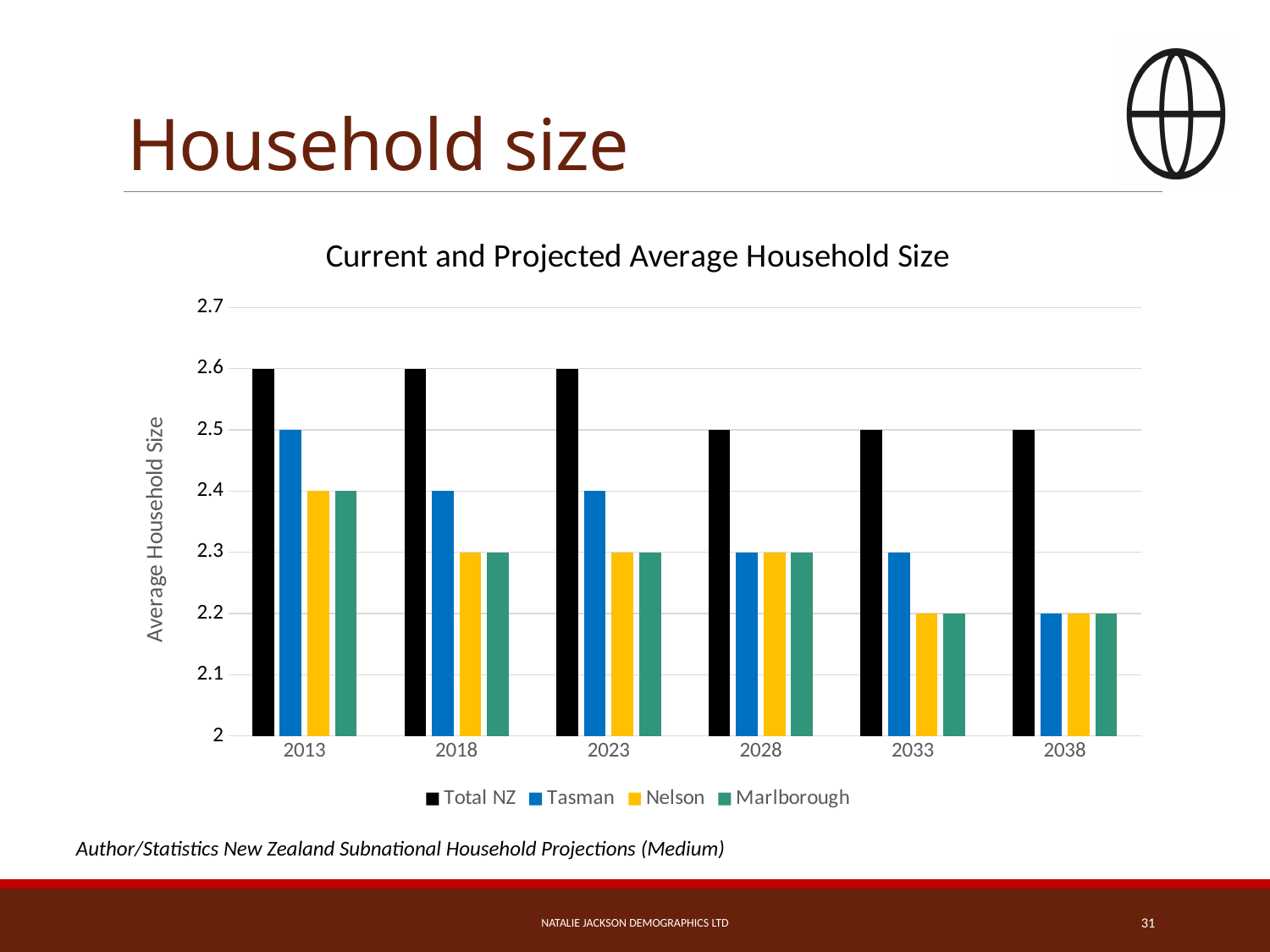
Which series has the highest value in 2028? Total NZ What is the title of the chart? Current and Projected Average Household Size What is the difference between Total NZ and Tasman in 2038? 0.3 What is the value for Nelson in 2038? 2.2 How many series does the legend list? 4 Does the Tasman series rise or fall from 2013 to 2038? fall Which is larger in 2033, Tasman or Nelson? Tasman What is the value for Marlborough in 2018? 2.3 What is the value for Tasman in 2013? 2.5 What kind of chart is shown on the slide? bar chart What is the value for Total NZ in 2013? 2.6 How many years are shown along the x axis? 6